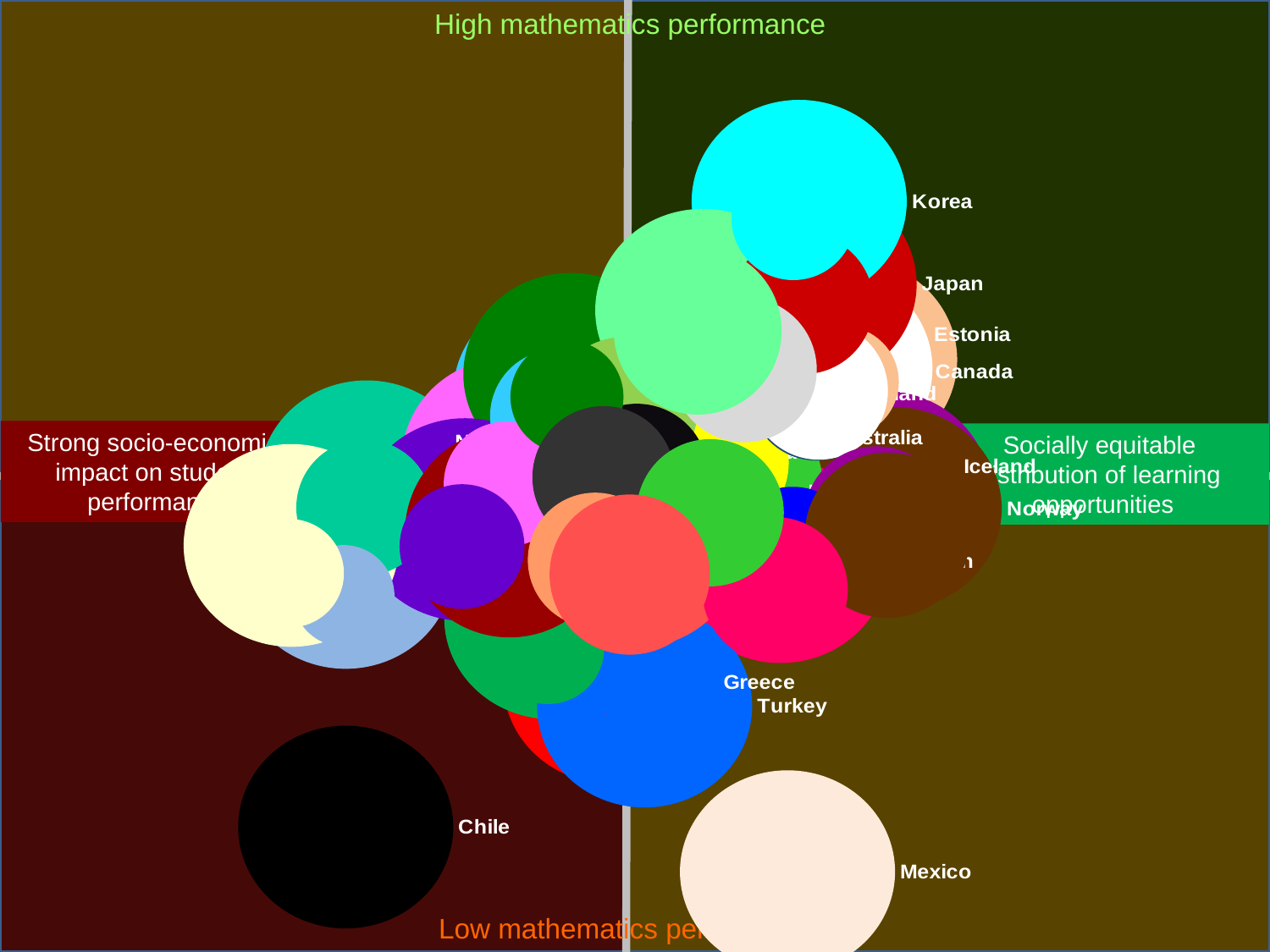
Is Chile's bubble on the 'Strong socio-economic impact' side or the 'Socially equitable distribution' side of the chart? Strong socio-economic impact Is Korea's bubble in the high or low mathematics performance half of the chart? High mathematics performance Which country has higher mathematics performance, Japan or Chile? Japan What kind of chart is shown on the slide? Bubble chart Which labelled country has the lowest mathematics performance (the bubble placed lowest on the chart)? Mexico Is Chile's bubble in the high or low mathematics performance half of the chart? Low mathematics performance Which labelled country has the highest mathematics performance (the bubble placed highest on the chart)? Korea Which country has higher mathematics performance, Korea or Greece? Korea What is the label written at the top of the chart? High mathematics performance What colour is the bubble for Chile? Black Which country has higher mathematics performance, Korea or Mexico? Korea